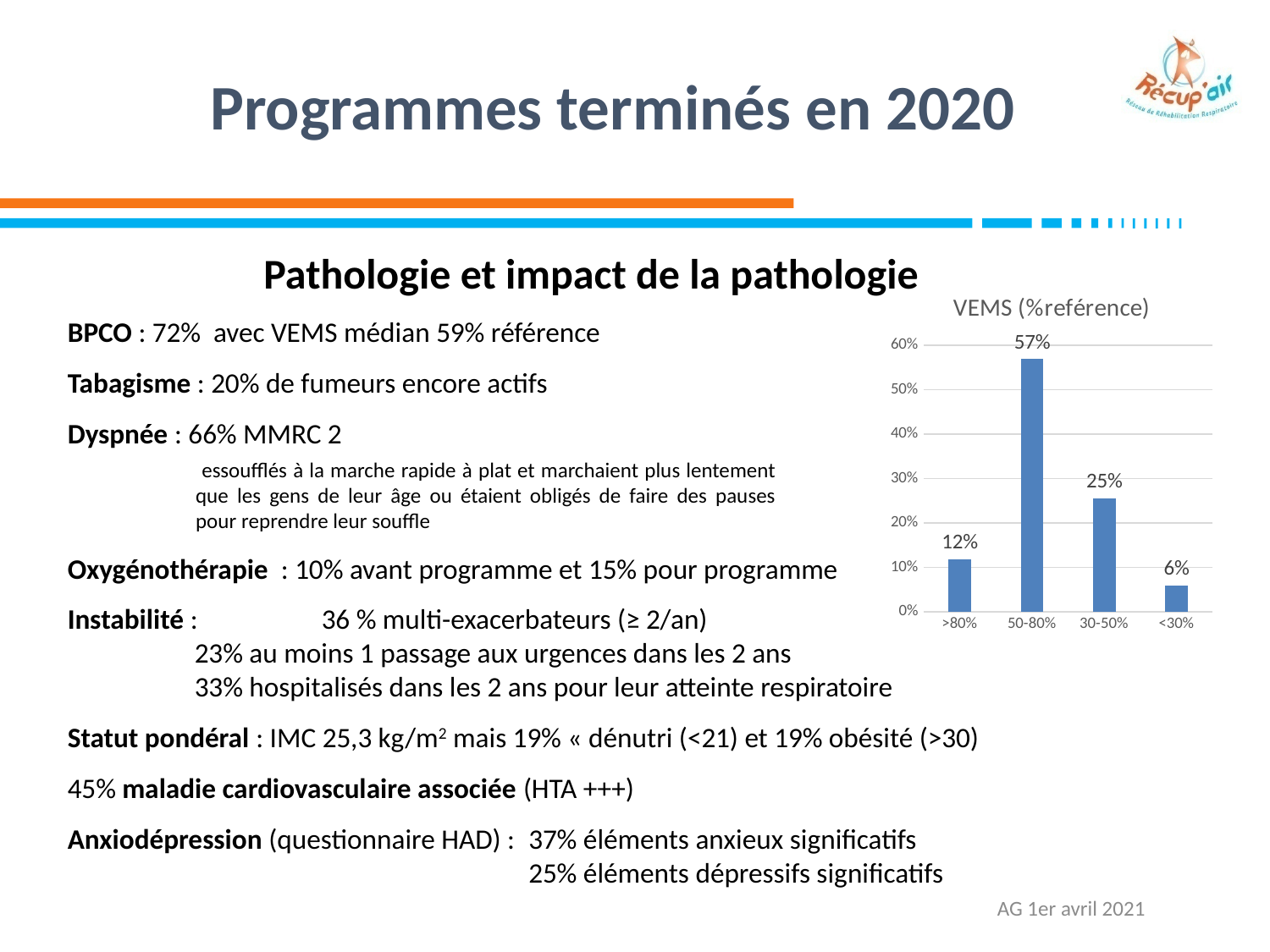
Which category has the highest value in the VEMS (%reférence) chart? 50-80% What is the value for the 50-80% category in the VEMS (%reférence) chart? 57% How many categories are shown in the VEMS (%reférence) chart? 4 What is the highest value shown on the vertical axis of the VEMS (%reférence) chart? 60% What is the value for the >80% category in the VEMS (%reférence) chart? 12% Which is larger in the VEMS (%reférence) chart: the value for >80% or the value for 30-50%? 30-50% What is the difference between the 50-80% and 30-50% values in the VEMS (%reférence) chart? 32% Which category has the lowest value in the VEMS (%reférence) chart? <30% Is the value for 30-50% in the VEMS (%reférence) chart greater or less than 20%? greater What is the title of the chart on the slide? VEMS (%reférence) What is the value for the <30% category in the VEMS (%reférence) chart? 6% What kind of chart is the VEMS (%reférence) chart? bar chart